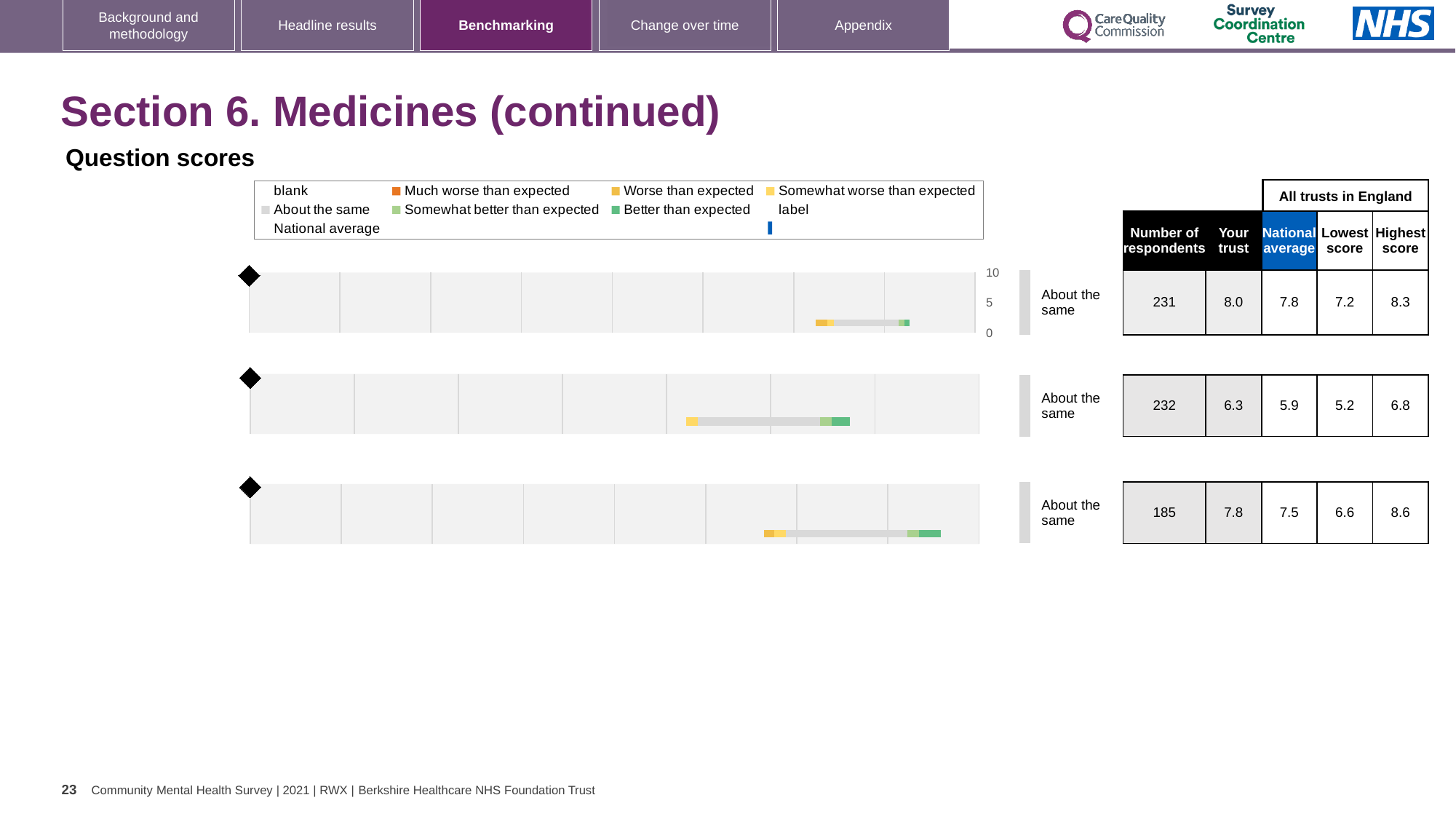
What benchmark category is given for the bottom chart? About the same How many benchmarking charts are shown on the slide? 3 For the top chart's row in the table, what is the 'Your trust' score? 8.0 What kind of chart is used for the three benchmarking charts on the slide? bar chart For the bottom chart's row in the table, what is the highest score among all trusts in England? 8.6 For the middle chart's row, what is the difference between the 'Your trust' score and the national average? 0.4 For the middle chart's row in the table, what is the national average? 5.9 In the legend, which entry is shown in orange? Much worse than expected What is the highest value shown on the vertical axis of the top chart? 10 For the top chart's row in the table, what is the number of respondents? 231 Which of the three rows has the lowest 'Your trust' score? middle chart's row Which row has the larger 'Your trust' score, the top chart's row or the bottom chart's row? top chart's row